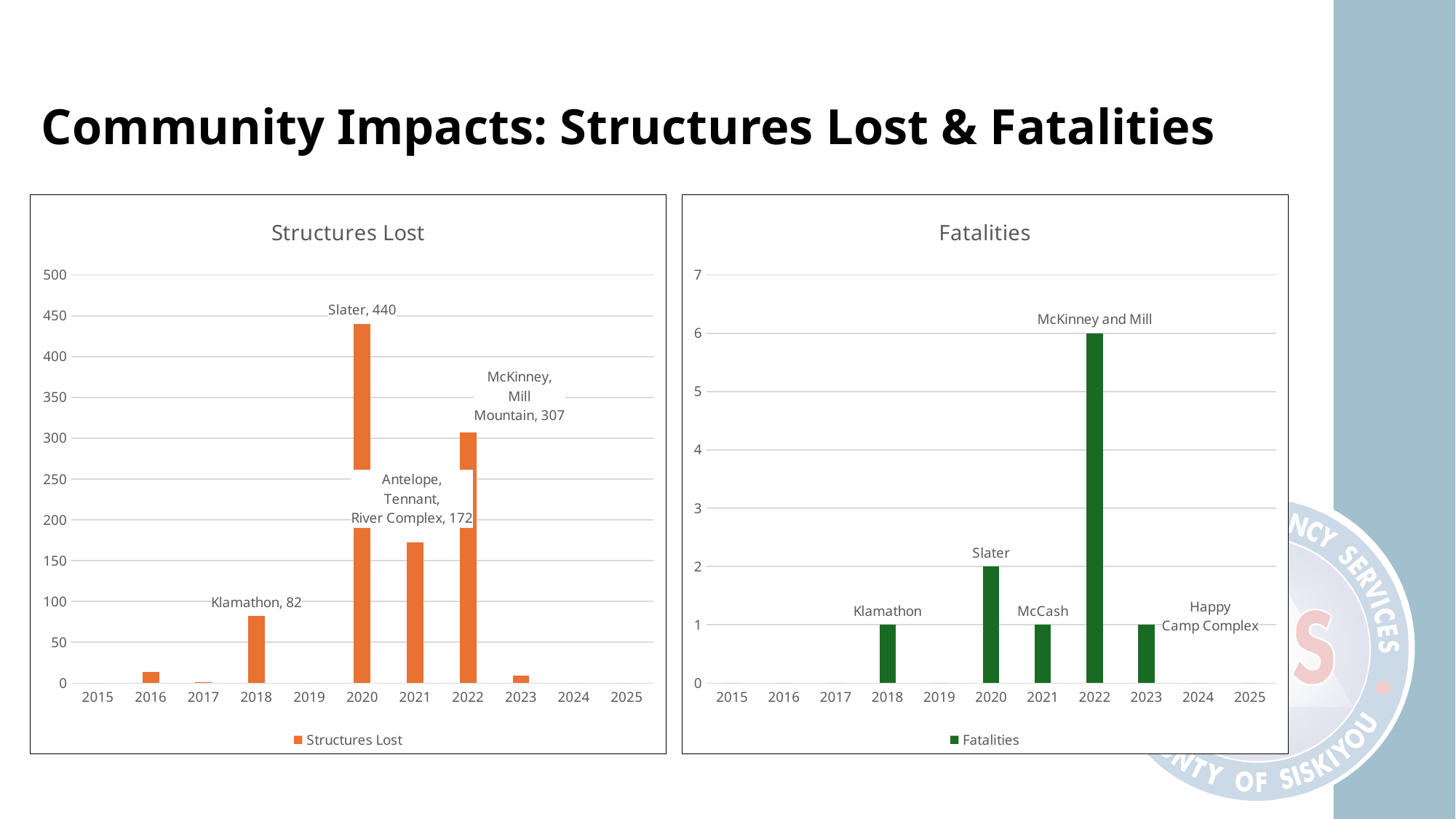
In the Structures Lost chart, which year had more structures lost, 2021 or 2022? 2022 In the Structures Lost chart, what is the value for 2018? 82 In the Fatalities chart, how many fatalities are shown for 2022? 6 In the Fatalities chart, what is the difference between the fatalities in 2022 and in 2020? 4 In the Structures Lost chart, which year has the highest number of structures lost? 2020 In the Structures Lost chart, is the value for 2016 greater or less than 50? less What kind of chart is the Fatalities chart? bar chart In the Structures Lost chart, what is the difference between the structures lost in 2020 and in 2022? 133 In the Fatalities chart, how many fatalities are shown for 2020? 2 How many years are shown on the x axis of the Fatalities chart? 11 In the Structures Lost chart, how many structures were lost in 2022? 307 In the Structures Lost chart, how many structures were lost in 2020? 440